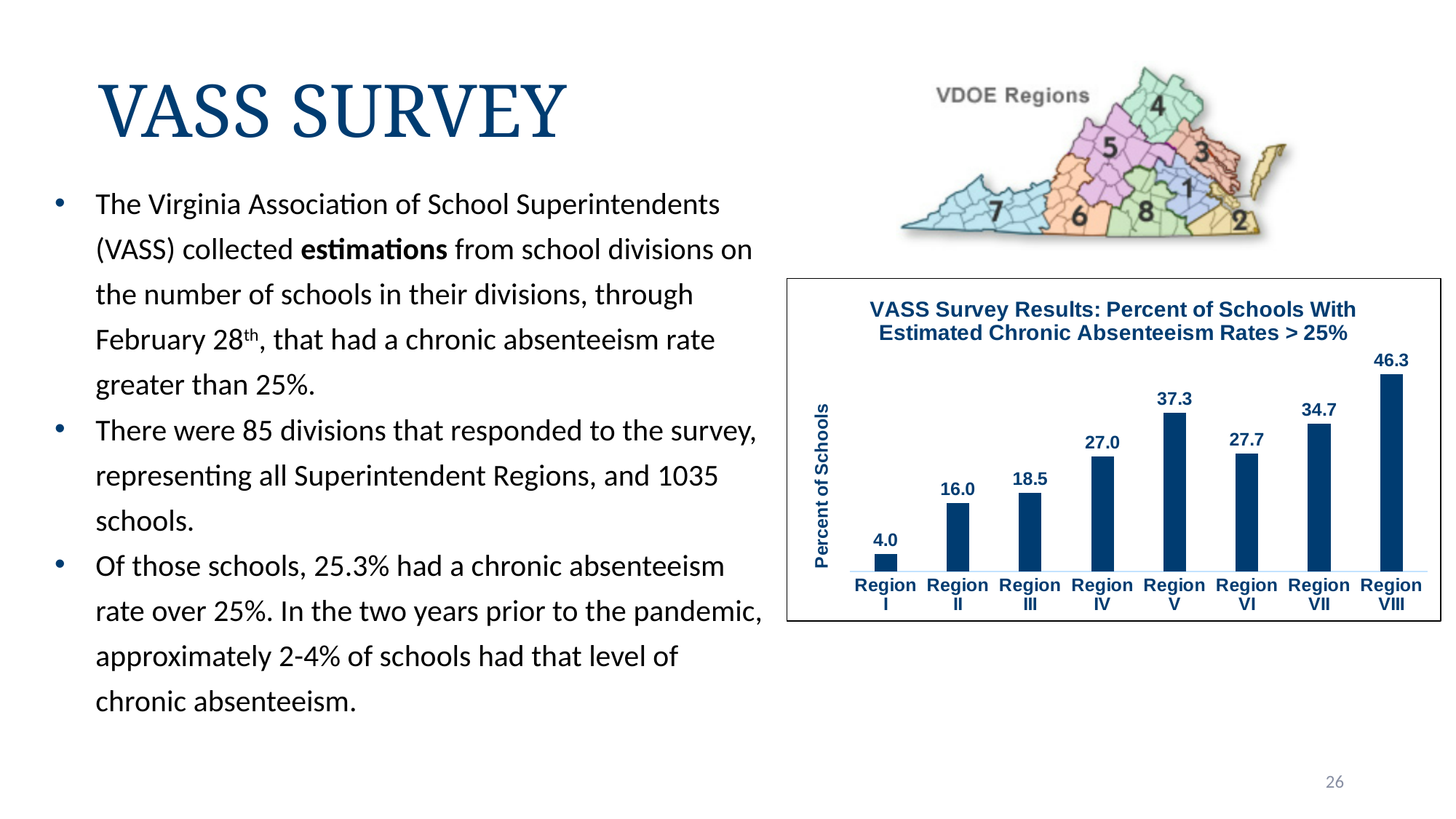
What kind of chart is shown on the slide? Bar chart Which is larger, the value for Region II or the value for Region VII? Region VII What is the difference between the values for Region V and Region IV? 10.3 What is the value for Region V? 37.3 Which region has the highest percent of schools? Region VIII Which region has the lowest percent of schools? Region I What is the difference between the values for Region VIII and Region I? 42.3 Which is larger, the value for Region III or the value for Region VI? Region VI How many regions are shown in the chart? 8 What is the value for Region I? 4.0 What is the label of the vertical axis of the chart? Percent of Schools What is the value for Region VII? 34.7